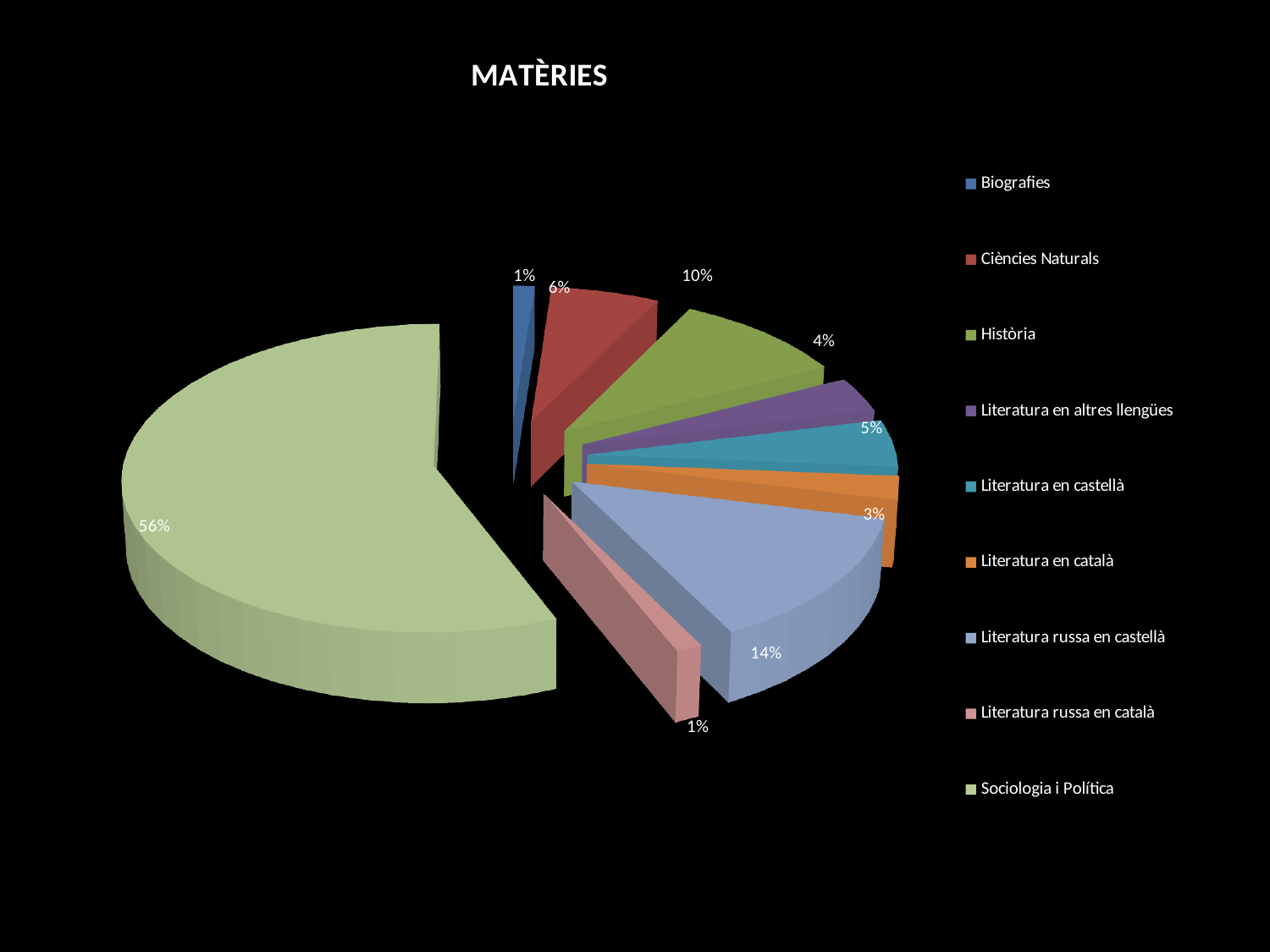
What kind of chart is shown on the slide? Pie chart Which is larger, the share for Literatura en castellà or the share for Literatura en altres llengües? Literatura en castellà What is the title of the chart? MATÈRIES What share of the pie does Literatura en català represent? 3% How many categories does the legend list? 9 What share of the pie does Literatura russa en castellà represent? 14% What share of the pie does Sociologia i Política represent? 56% Which category has the largest share of the pie? Sociologia i Política What colour is the slice for Literatura russa en català? Pink What is the difference in percentage points between the shares of Sociologia i Política and Literatura russa en castellà? 42